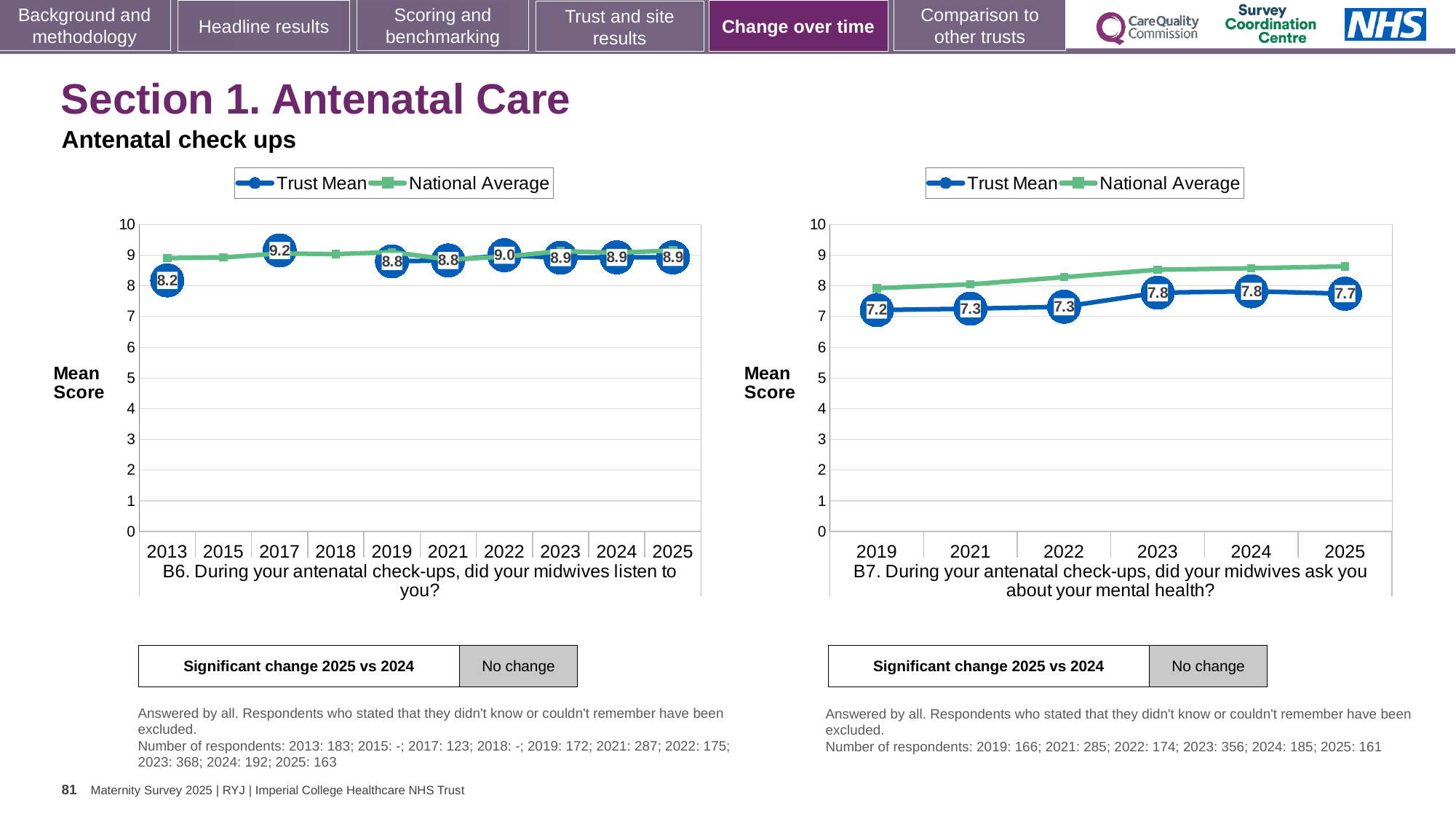
In the B6 chart (left), what is the difference between the Trust Mean for 2017 and the Trust Mean for 2013? 1.0 In the B6 chart (left), how many series does the legend list? 2 In the B7 chart (right), which year has the lowest Trust Mean? 2019 In the B7 chart (right), what is the Trust Mean for 2019? 7.2 What kind of chart is the B7 chart (right)? line chart In the B7 chart (right), what is the Trust Mean for 2025? 7.7 In the B6 chart (left), what is the Trust Mean for 2025? 8.9 In the B7 chart (right), how many years are plotted on the x axis? 6 In the B6 chart (left), which year has the lowest Trust Mean? 2013 In the B6 chart (left), what is the Trust Mean for 2013? 8.2 In the B7 chart (right), is the Trust Mean for 2023 larger or smaller than the Trust Mean for 2022? larger In the B6 chart (left), which year has the highest Trust Mean? 2017